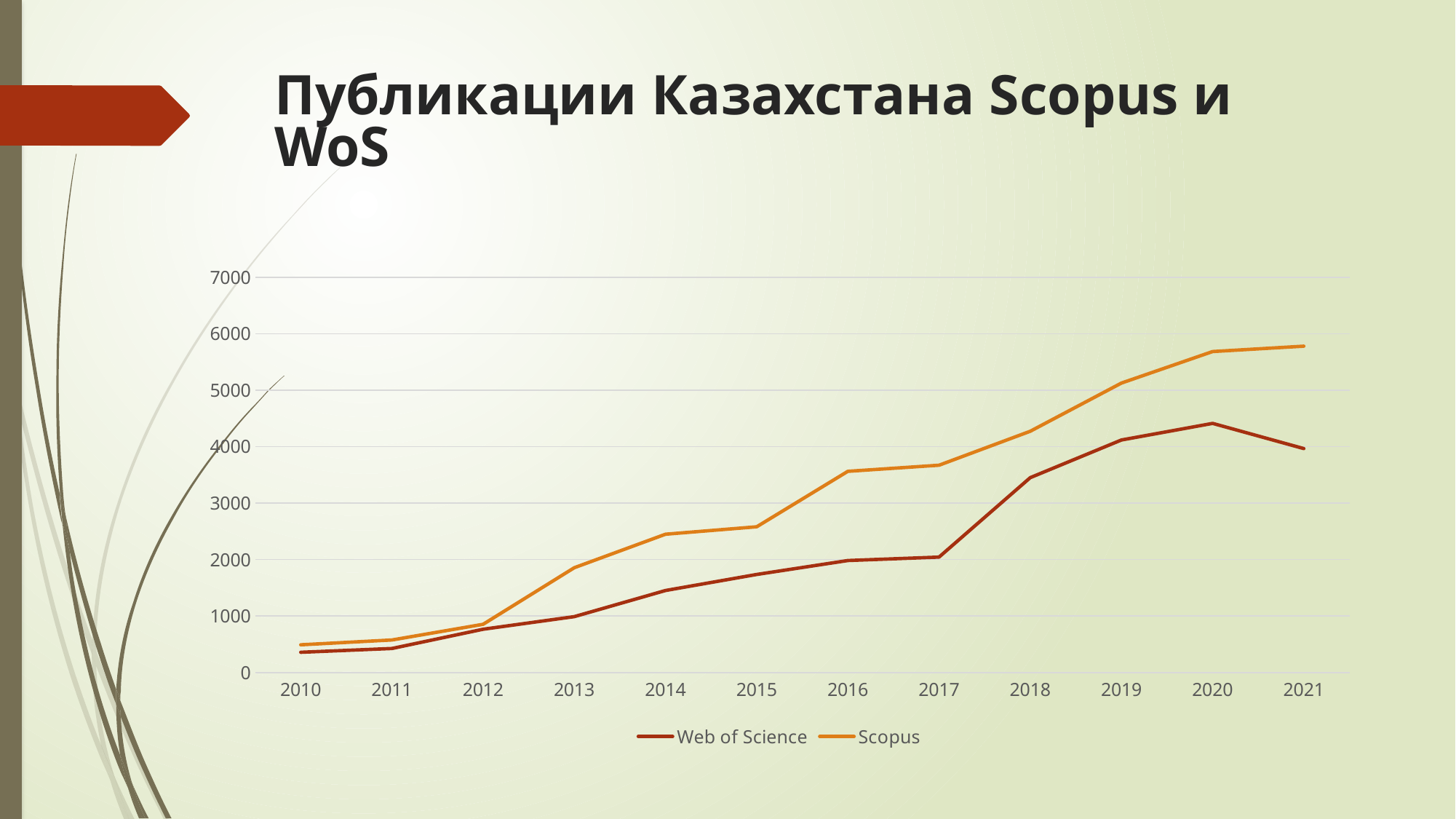
Is the Scopus value for 2013 greater or less than 2000? less Is the Scopus value for 2021 greater or less than 5000? greater Is the Web of Science value for 2014 greater or less than 1000? greater In which year does the Web of Science series reach its highest value? 2020 How many years are shown on the x axis? 12 In which year is the Web of Science series at its lowest value? 2010 What kind of chart is shown on the slide? line chart Does the Web of Science series rise or fall between 2020 and 2021? fall How many series does the legend list? 2 What are the two series named in the legend? Web of Science and Scopus In 2016, which series has the larger value, Web of Science or Scopus? Scopus